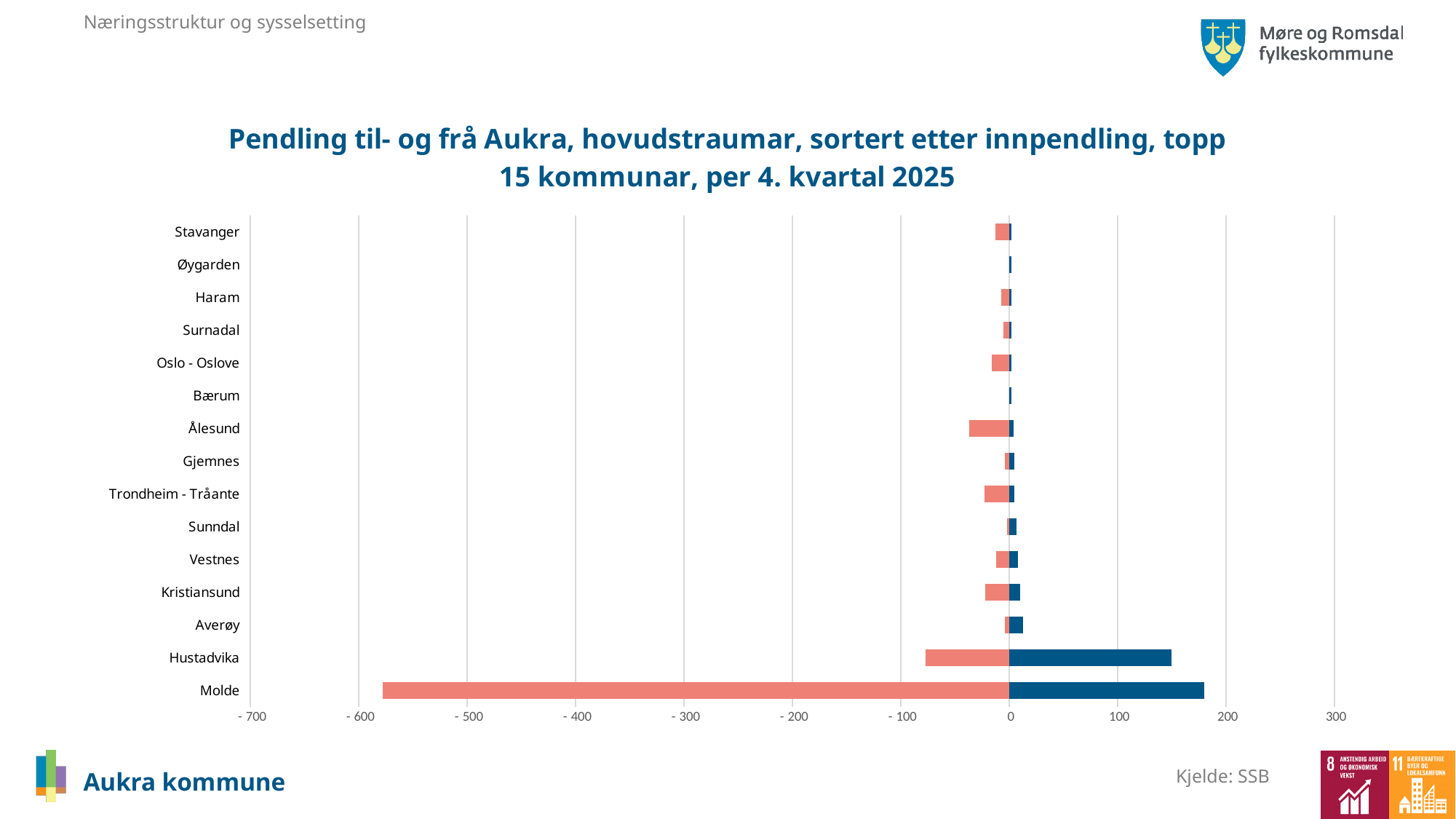
Going down the chart from Stavanger to Molde, do the blue bars get longer or shorter? longer Which has the longer blue bar, Hustadvika or Averøy? Hustadvika Is the red bar for Molde greater or less than -500? less What kind of chart is shown on the slide? bar chart Which municipality has the longest blue bar (extending furthest to the right)? Molde How many municipalities (categories) are listed on the vertical axis of the chart? 15 Is the blue bar for Molde greater or less than 100? greater Is the blue bar for Hustadvika greater or less than 100? greater What source is cited for the chart data at the bottom of the slide? SSB Which municipality has the longest red bar (extending furthest to the left)? Molde